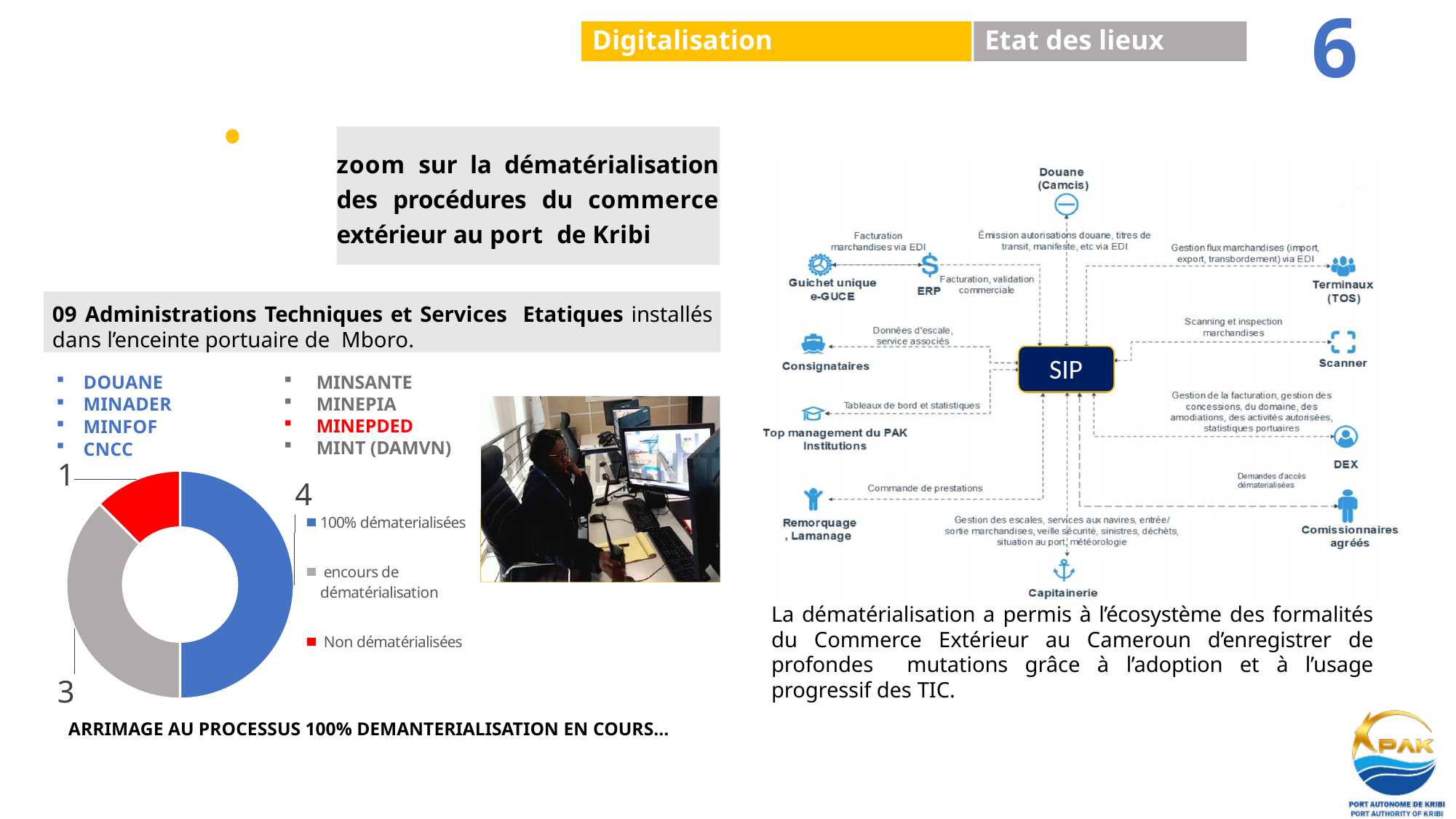
What is the value for "100% dématerialisées" in the doughnut chart? 4 What share of the doughnut chart does the "100% dématerialisées" slice represent? 50% Which category has the largest slice in the doughnut chart? 100% dématerialisées Which is larger in the doughnut chart: "encours de dématérialisation" or "Non dématérialisées"? encours de dématérialisation What is the value for "Non dématérialisées" in the doughnut chart? 1 What is the value for "encours de dématérialisation" in the doughnut chart? 3 How many series does the legend of the doughnut chart list? 3 How many slices does the doughnut chart have? 3 What colour is the "Non dématérialisées" slice in the doughnut chart? Red What kind of chart is shown on the left of the slide? Doughnut chart Which category has the smallest slice in the doughnut chart? Non dématérialisées What is the difference between the "100% dématerialisées" value and the "Non dématérialisées" value in the doughnut chart? 3